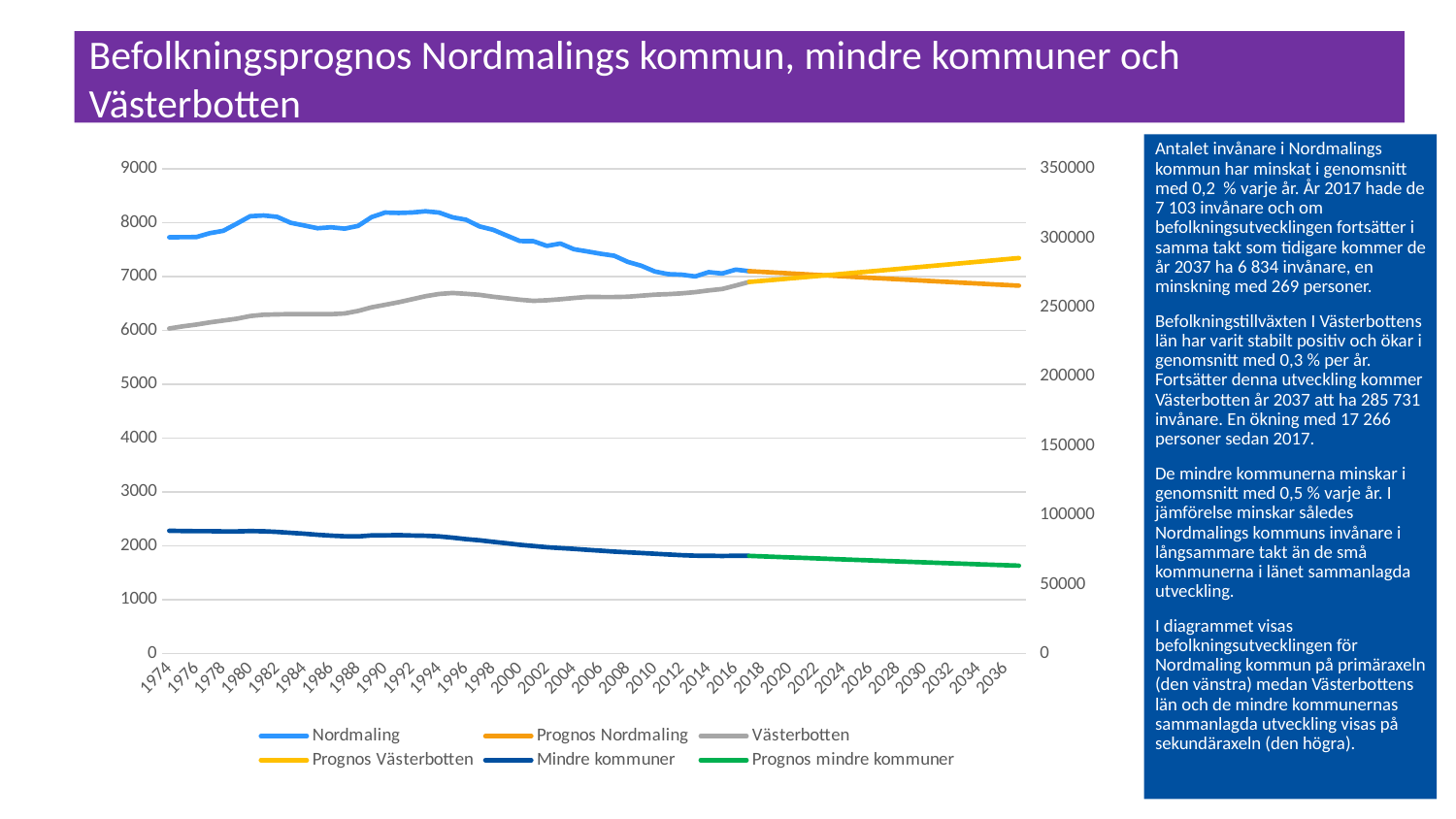
What is the title of the chart on the slide? Befolkningsprognos Nordmalings kommun, mindre kommuner och Västerbotten What kind of chart is shown on the slide? Line chart Which is larger: the Västerbotten value in 1974 or the Västerbotten value in 2016? 2016 Which series is drawn in green in the chart? Prognos mindre kommuner Does the Västerbotten line rise or fall overall from 1974 to 2016? Rise Which is larger: the Nordmaling value in 1974 or the Nordmaling value in 2016? 1974 How many series does the legend list? 6 On the left axis, is the value for Prognos Nordmaling in 2036 greater or less than 7000? less Does the Prognos mindre kommuner line rise or fall from 2018 to 2036? Fall Does the Nordmaling line rise or fall overall from 1974 to 2016? Fall On the left axis, is the value for Nordmaling in 1974 greater or less than 7000? greater